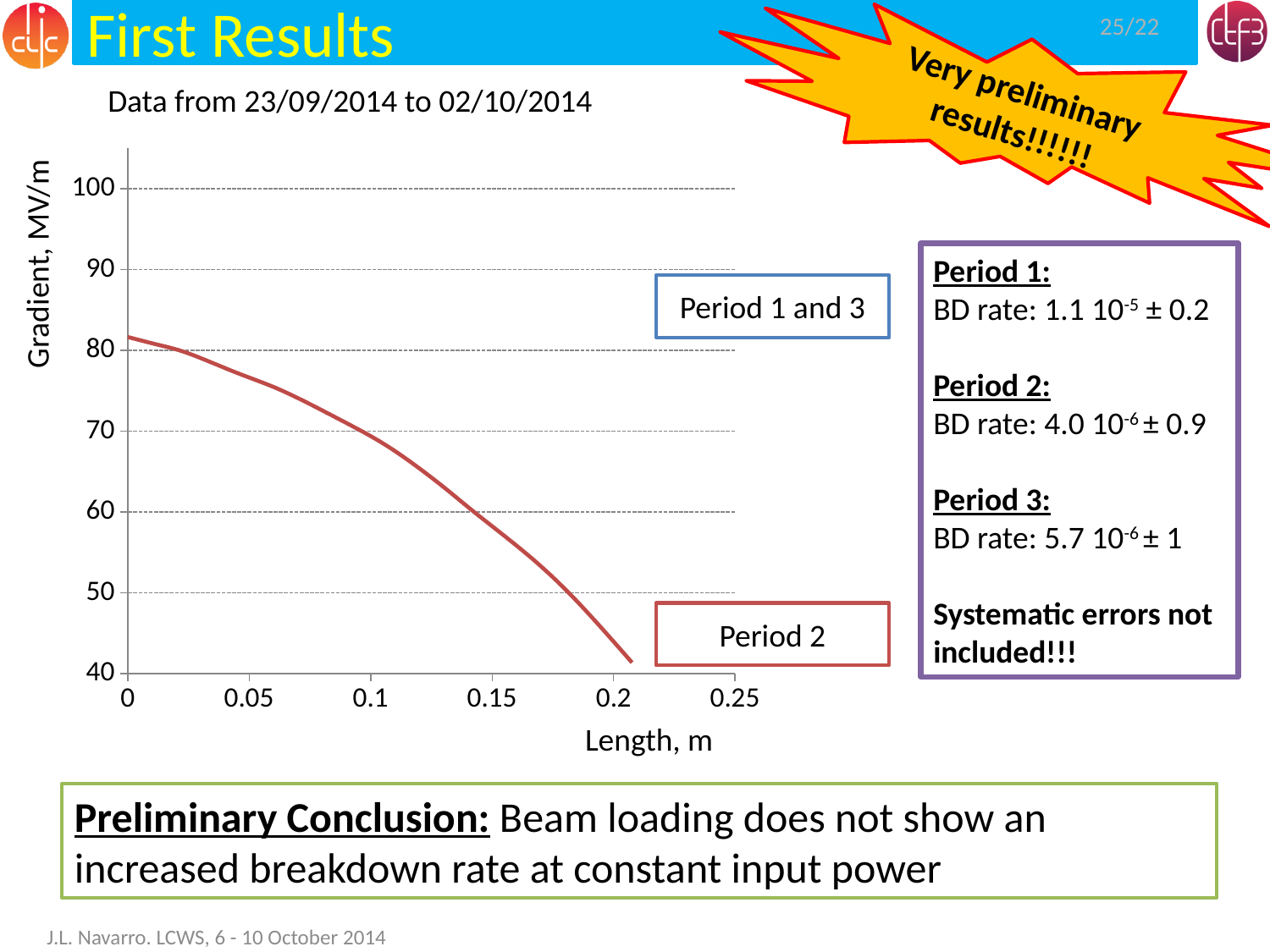
Is the gradient at length 0.15 m greater or less than 70 MV/m? less Is the gradient at length 0.1 m greater or less than 60 MV/m? greater What is the label of the x axis of the chart? Length, m What is the label of the y axis of the chart? Gradient, MV/m Is the gradient at length 0 m greater or less than 70 MV/m? greater How many lines are plotted on the chart? 1 What kind of chart is shown on the slide? line chart Does the gradient rise or fall as length increases along the x axis? fall